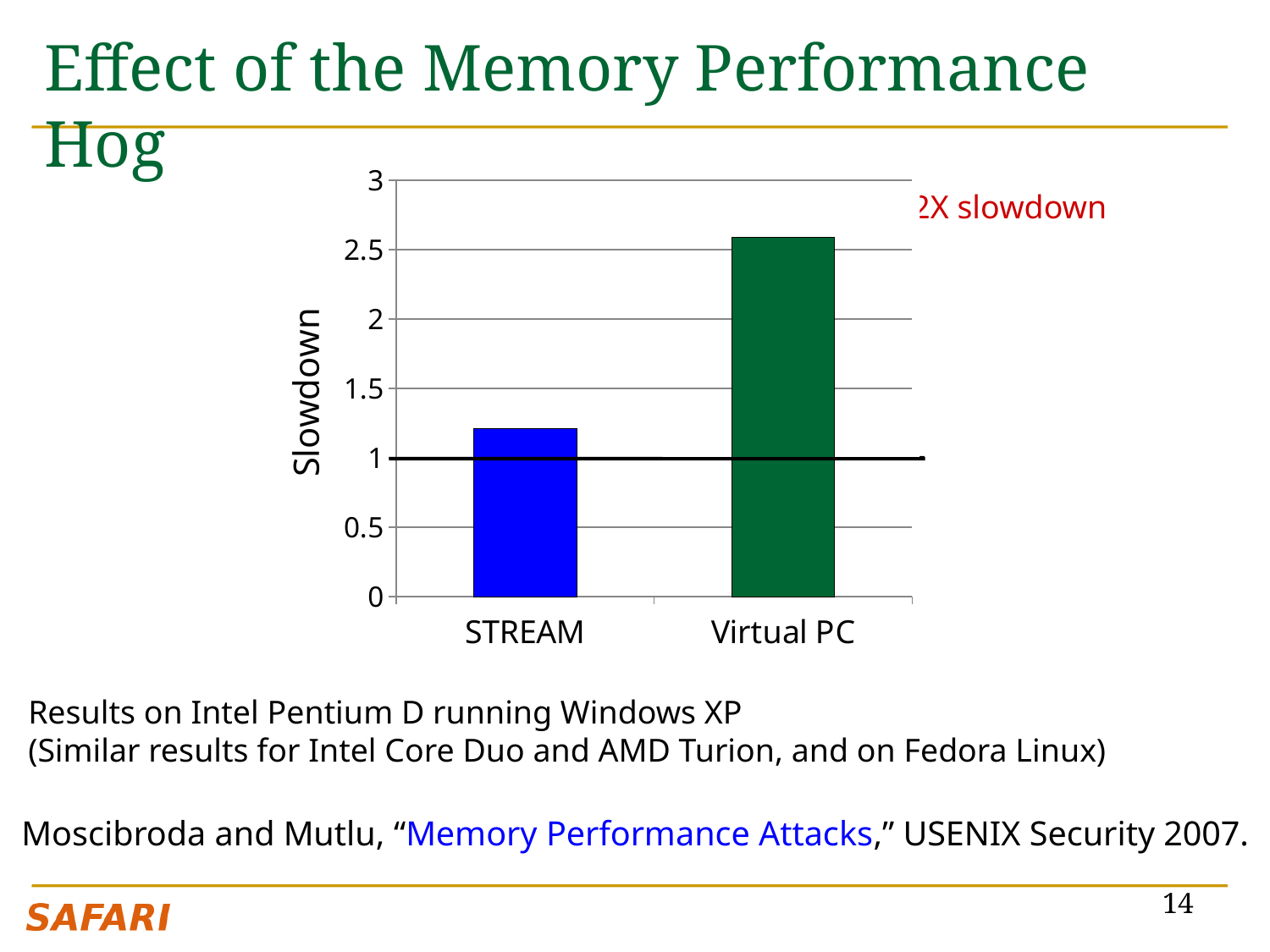
Which category has the highest slowdown in the chart? Virtual PC Which category has the lowest slowdown in the chart? STREAM What is the highest tick value shown on the y axis of the chart? 3 Which has a larger slowdown, STREAM or Virtual PC? Virtual PC What kind of chart is shown on the slide? bar chart Is the slowdown value for Virtual PC greater or less than 2? greater Is the slowdown value for STREAM greater or less than 1.5? less What is the label of the y axis of the chart? Slowdown How many categories are plotted on the x axis of the chart? 2 Is the slowdown value for STREAM greater or less than 1? greater